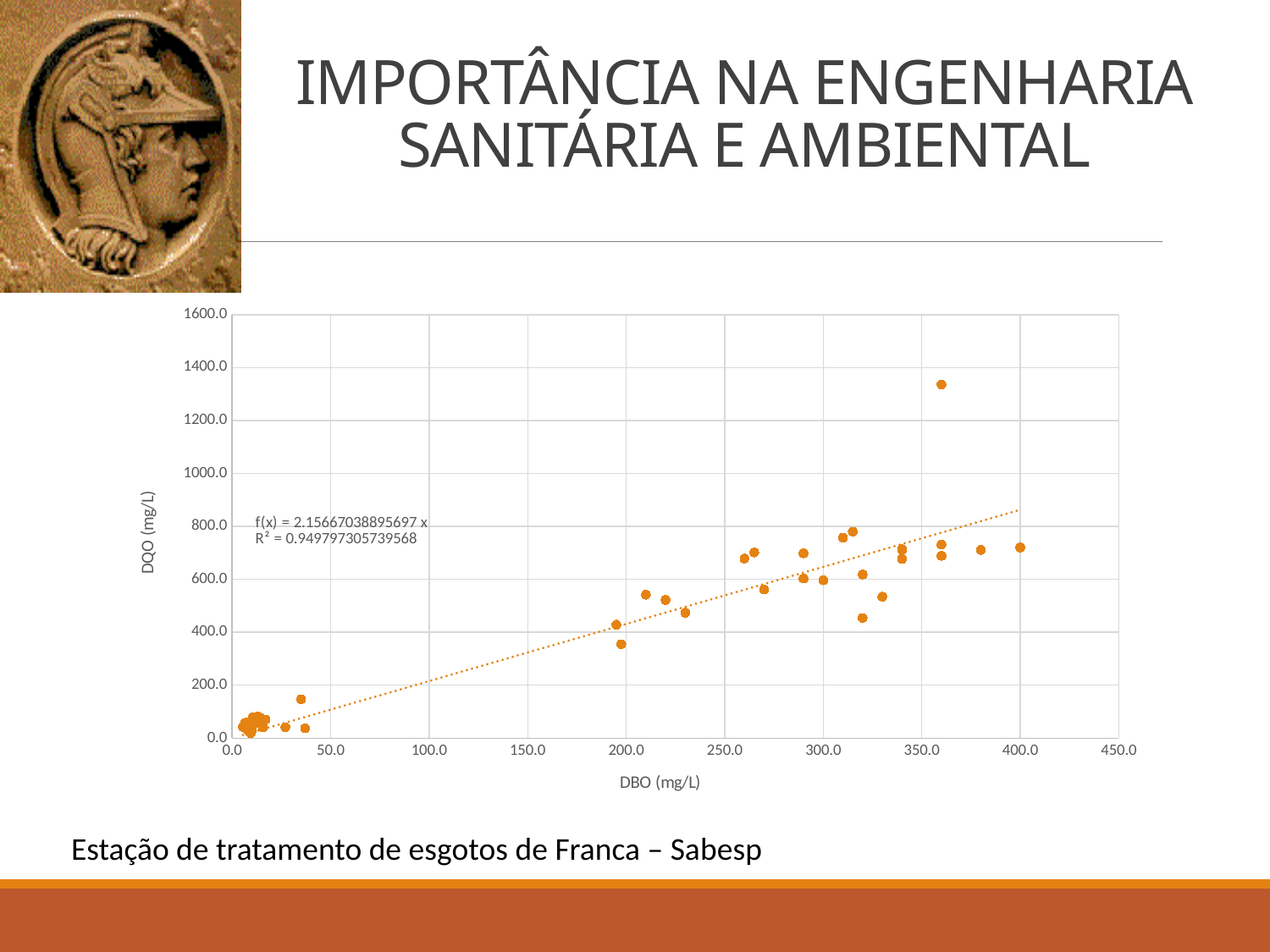
Is the DQO value of the point at DBO 400.0 greater or less than 600? greater What is the label of the y axis of the chart? DQO (mg/L) Are the DQO values of the points below DBO 50.0 greater or less than 200? less Is the DQO value of the point at DBO 400.0 greater or less than 800? less What kind of chart is shown on the slide? Scatter chart What is the label of the x axis of the chart? DBO (mg/L) Which point has the higher DQO value: the point at DBO 400.0 or the highest point near DBO 360.0? The point near DBO 360.0 What is the maximum value shown on the x axis? 450.0 Do the DQO values generally rise or fall as DBO increases along the x axis? Rise